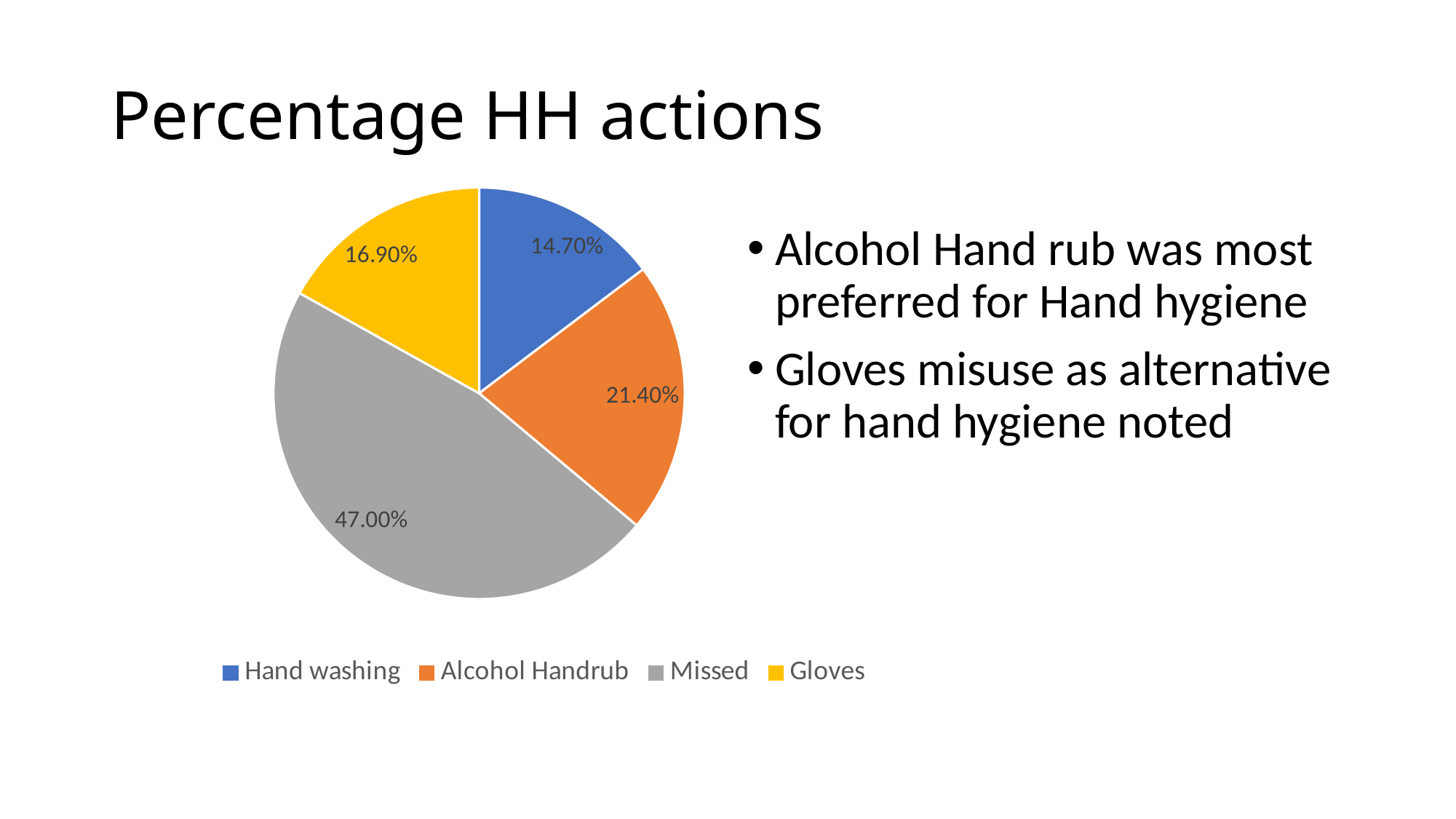
What percentage of HH actions is shown for Gloves? 16.90% What percentage of HH actions is shown for Alcohol Handrub? 21.40% What kind of chart is shown on the slide? Pie chart What is the difference between the Missed and Alcohol Handrub percentages? 25.60% What percentage of HH actions is shown for Hand washing? 14.70% Which category has the largest slice of the pie? Missed What is the title of the slide containing the chart? Percentage HH actions What percentage of HH actions is shown for Missed? 47.00% How many categories does the pie chart show? 4 Which category has the smallest slice of the pie? Hand washing Which is larger, the Gloves slice or the Hand washing slice? Gloves What colour is the Missed slice in the pie chart? Grey